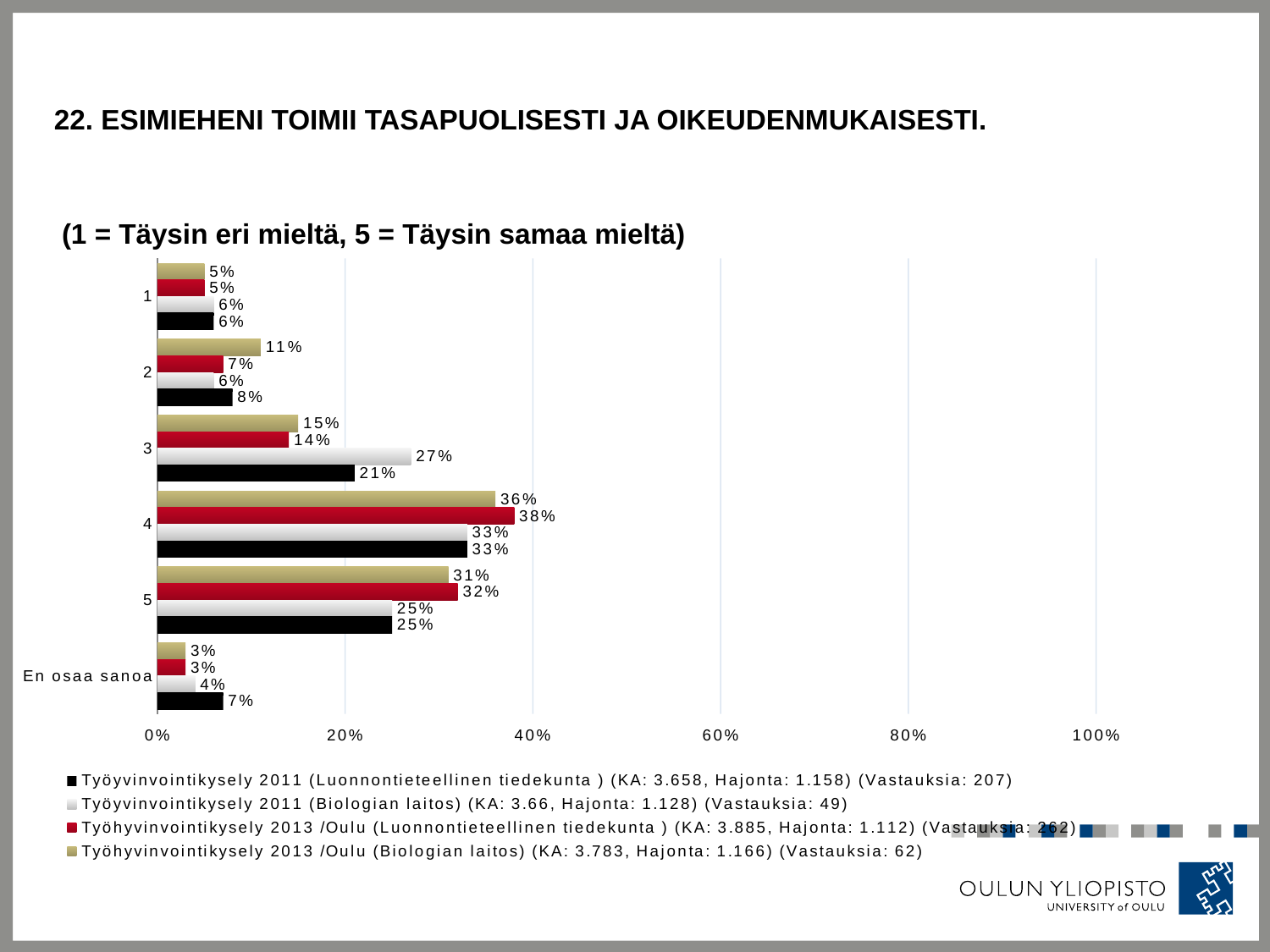
For category 5, which is larger: the Työhyvinvointikysely 2013 /Oulu (Luonnontieteellinen tiedekunta) value or the Työyvinvointikysely 2011 (Luonnontieteellinen tiedekunta) value? Työhyvinvointikysely 2013 /Oulu (Luonnontieteellinen tiedekunta) What is the value for 'En osaa sanoa' in the Työyvinvointikysely 2011 (Luonnontieteellinen tiedekunta) series? 7% Is the value for category 4 in the Työhyvinvointikysely 2013 /Oulu (Luonnontieteellinen tiedekunta) series greater or less than 40%? less What is the value for category 4 in the Työhyvinvointikysely 2013 /Oulu (Luonnontieteellinen tiedekunta) series? 38% What is the difference between the Työyvinvointikysely 2011 (Biologian laitos) value and the Työhyvinvointikysely 2013 /Oulu (Biologian laitos) value for category 3? 12% What is the value for category 2 in the Työhyvinvointikysely 2013 /Oulu (Biologian laitos) series? 11% Which category has the lowest value in the Työyvinvointikysely 2011 (Luonnontieteellinen tiedekunta) series? 1 What is the value for category 3 in the Työyvinvointikysely 2011 (Biologian laitos) series? 27% Which category has the highest value in the Työhyvinvointikysely 2013 /Oulu (Biologian laitos) series? 4 How many categories are shown on the vertical axis of the chart? 6 What type of chart is shown on the slide? bar chart How many series does the legend list? 4